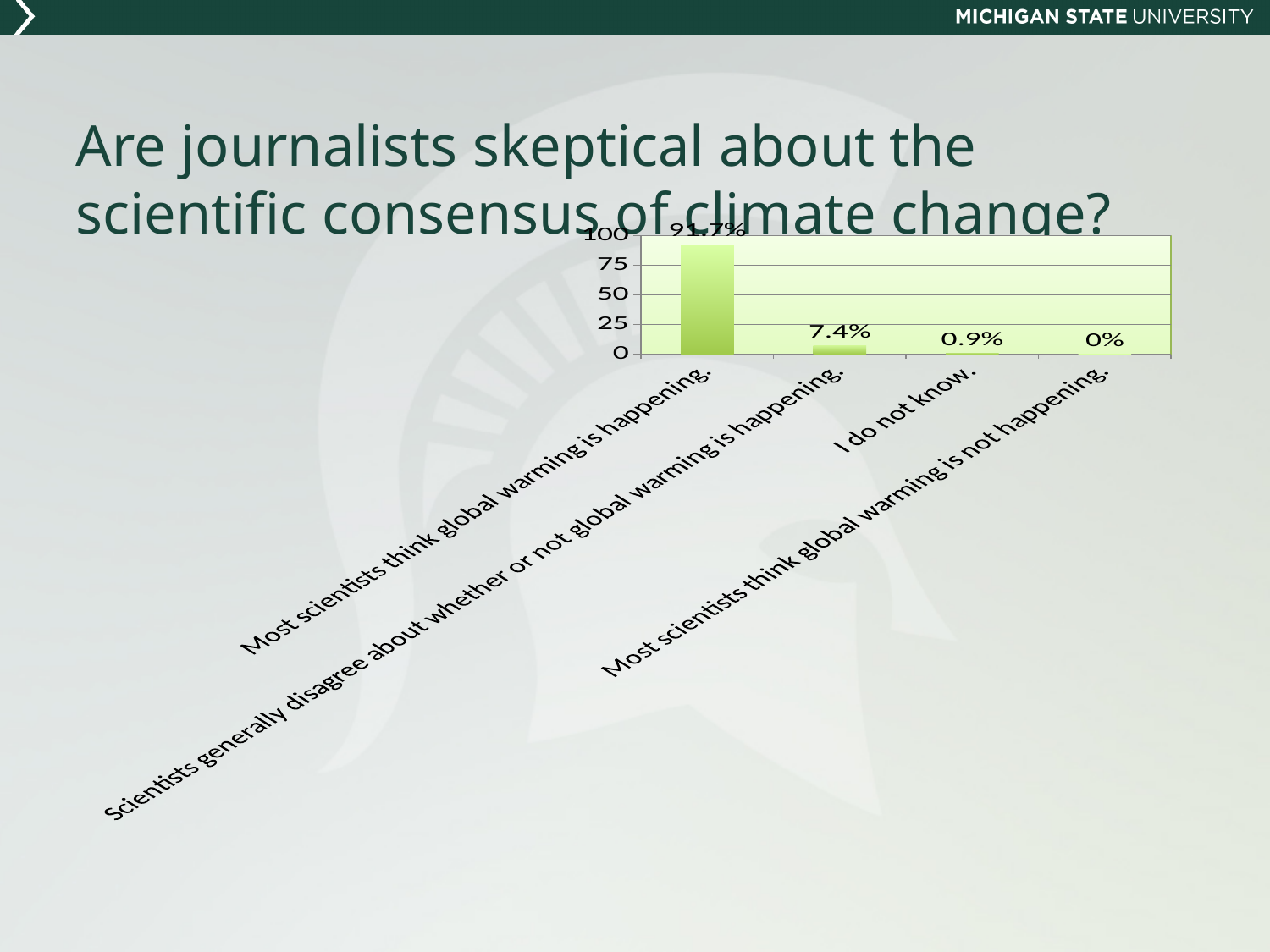
What is the value for "I do not know."? 0.9% What is the value for "Scientists generally disagree about whether or not global warming is happening."? 7.4% What kind of chart is shown on the slide? bar chart Which category has the highest value? Most scientists think global warming is happening. Which category has the lowest value? Most scientists think global warming is not happening. What is the difference between the values for "Most scientists think global warming is happening." and "Scientists generally disagree about whether or not global warming is happening."? 84.3% What is the value for "Most scientists think global warming is not happening."? 0% Which is larger: the value for "I do not know." or the value for "Scientists generally disagree about whether or not global warming is happening."? Scientists generally disagree about whether or not global warming is happening. What is the value for "Most scientists think global warming is happening."? 91.7% Do the values rise or fall from left to right along the x axis? fall How many categories are shown on the x axis? 4 Is the value for "Most scientists think global warming is happening." greater or less than 75? greater